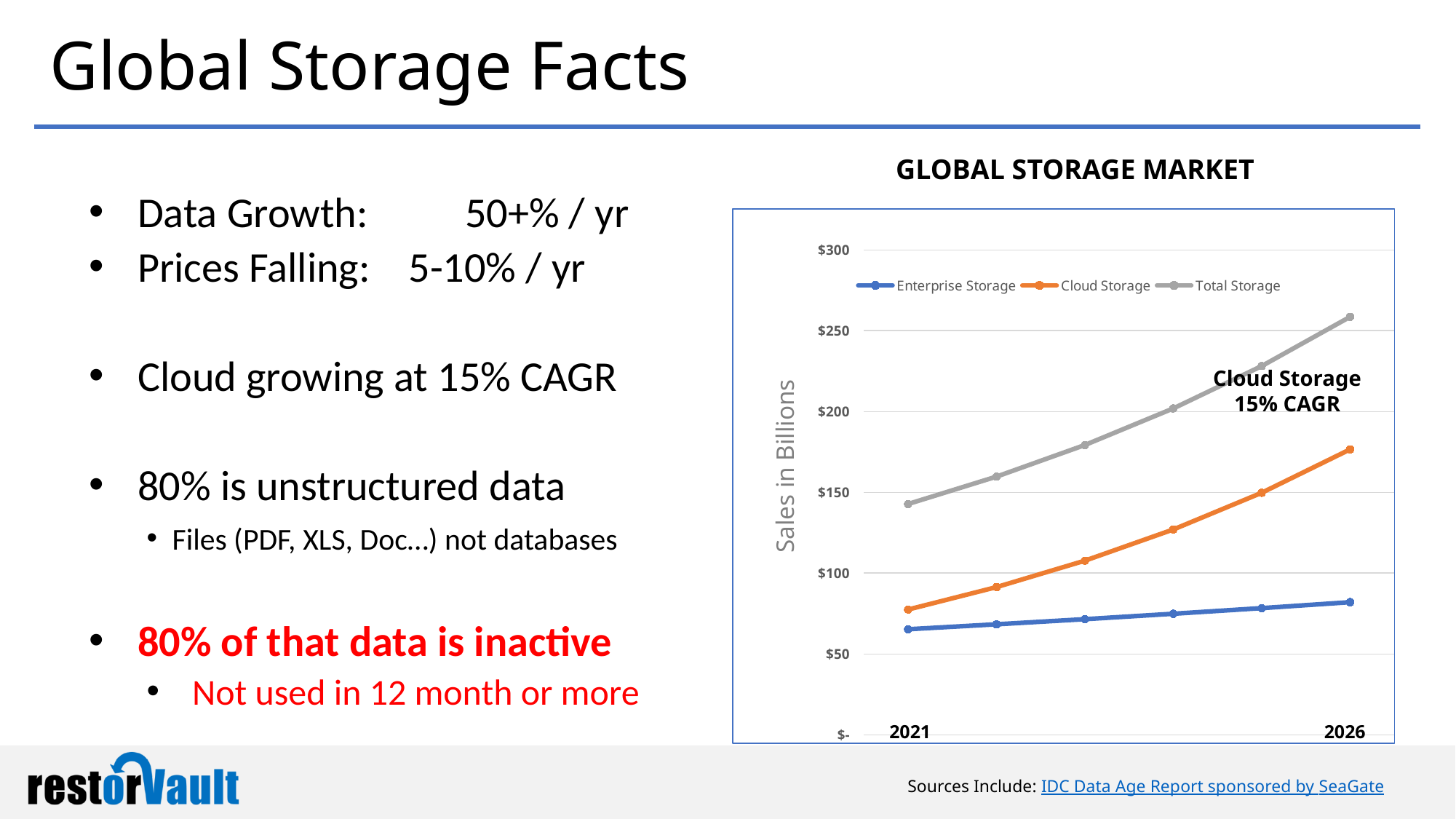
What is the label on the chart's vertical axis? Sales in Billions Does the Cloud Storage line rise or fall from 2021 to 2026? Rises What is the title of the chart? GLOBAL STORAGE MARKET Is the value for Enterprise Storage in 2026 greater or less than $100? less Is the value for Cloud Storage in 2021 greater or less than $100? less Is the value for Total Storage in 2026 greater or less than $200? greater How many data points does each line in the chart have? 6 How many series does the chart legend list? 3 In 2026, which is larger: Cloud Storage or Enterprise Storage? Cloud Storage What kind of chart is shown on the slide? Line chart Which series has the highest value in 2026? Total Storage